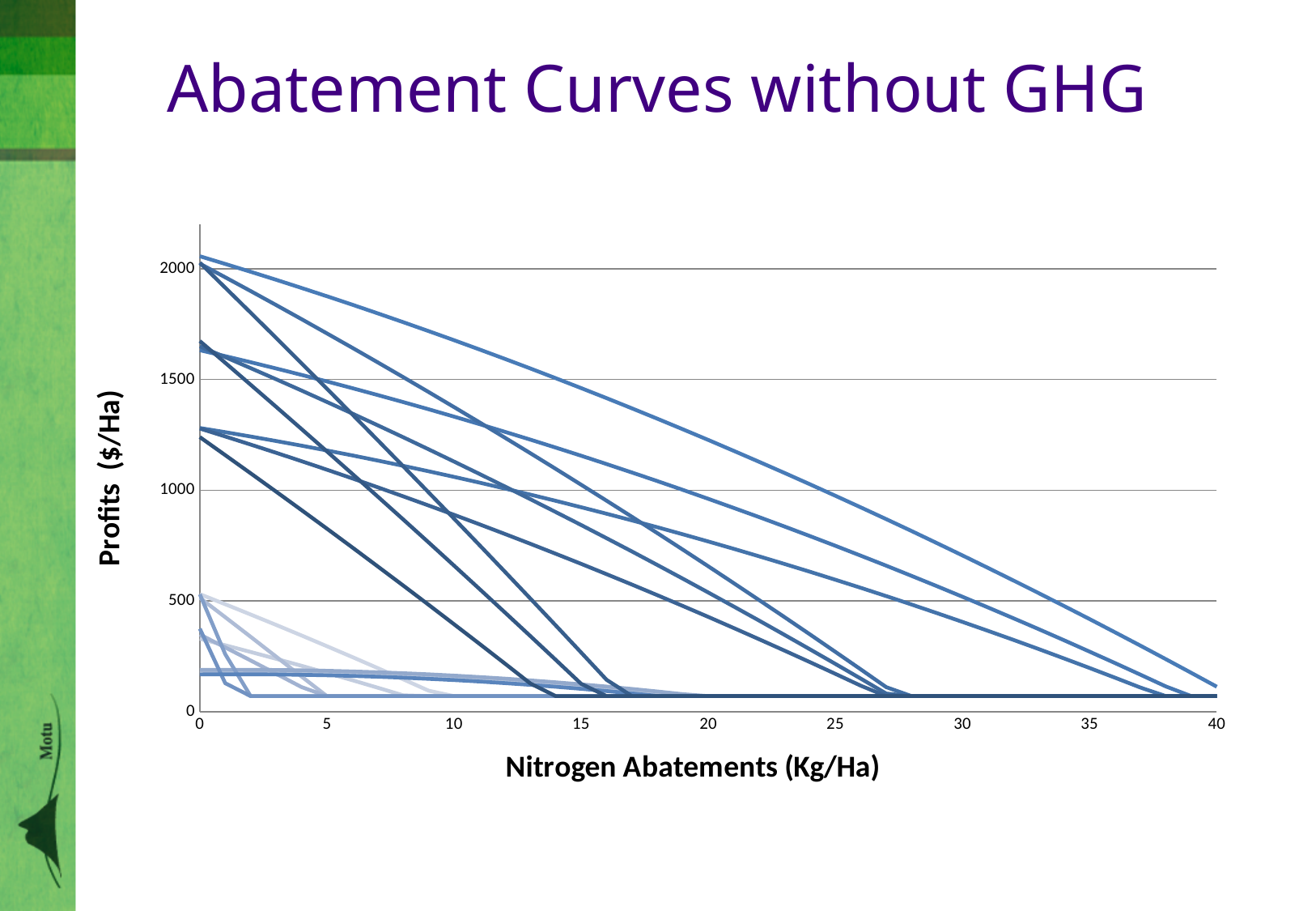
Is the value of the highest line at 40 Kg/Ha greater or less than 500? less Is the value of the highest line at 30 Kg/Ha greater or less than 1000? less Is the value of the highest line at 0 Kg/Ha greater or less than 1500? greater What is the label of the x axis? Nitrogen Abatements (Kg/Ha) Do the profit curves rise or fall as nitrogen abatement increases along the x axis? fall What kind of chart is shown on the slide? line chart What is the title of the chart? Abatement Curves without GHG